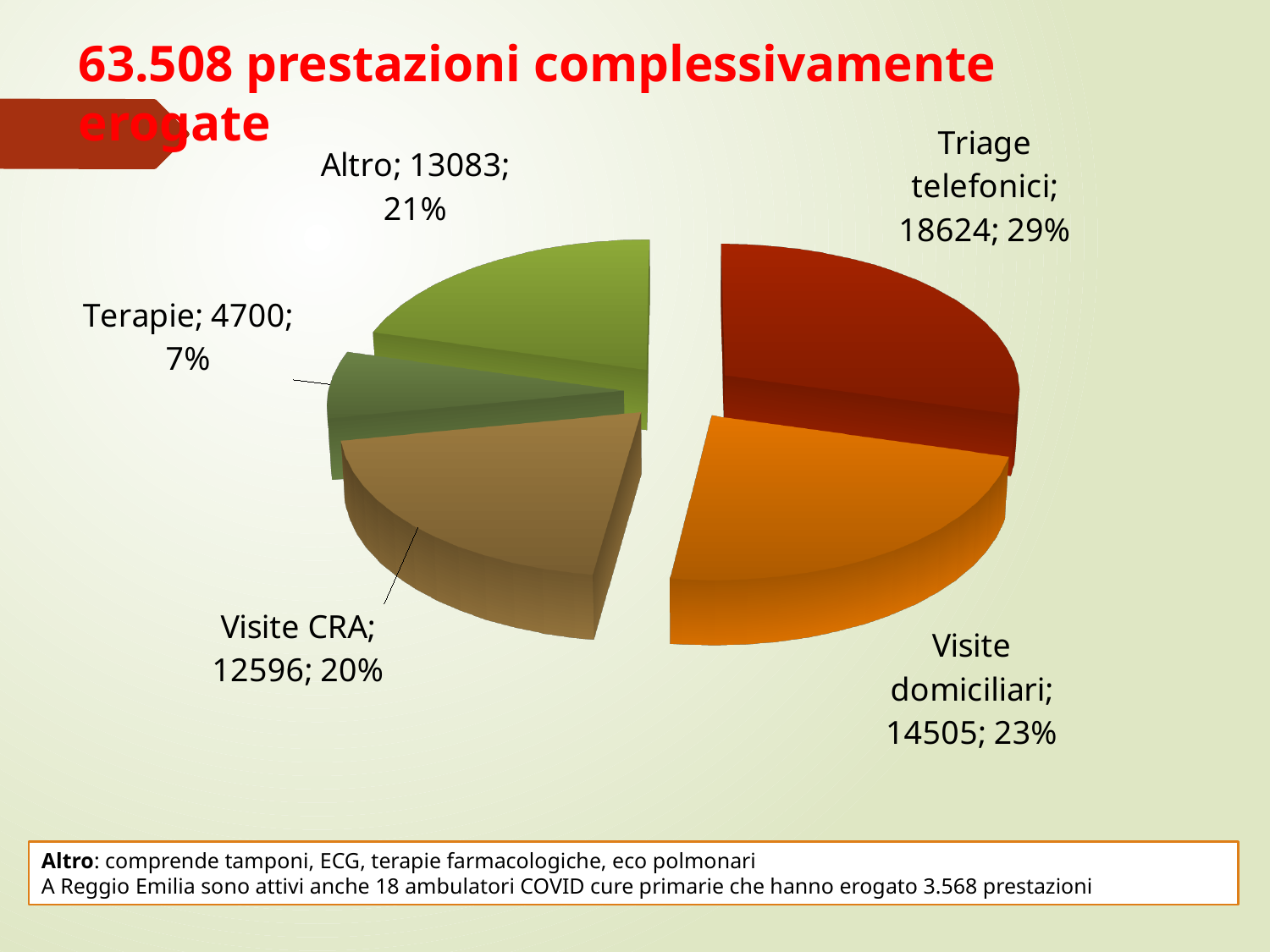
What is the value for Terapie? 4700 What is the title of the slide above the chart? 63.508 prestazioni complessivamente erogate What is the value for Triage telefonici? 18624 Which is larger, the value for Altro or the value for Visite CRA? Altro Which category has the smallest slice? Terapie What kind of chart is shown on the slide? pie chart Which category has the largest slice? Triage telefonici What share of the pie does Visite CRA represent? 20% What share of the pie does Altro represent? 21% What is the value for Visite domiciliari? 14505 How many slices does the pie chart have? 5 What is the difference between the values for Triage telefonici and Visite domiciliari? 4119